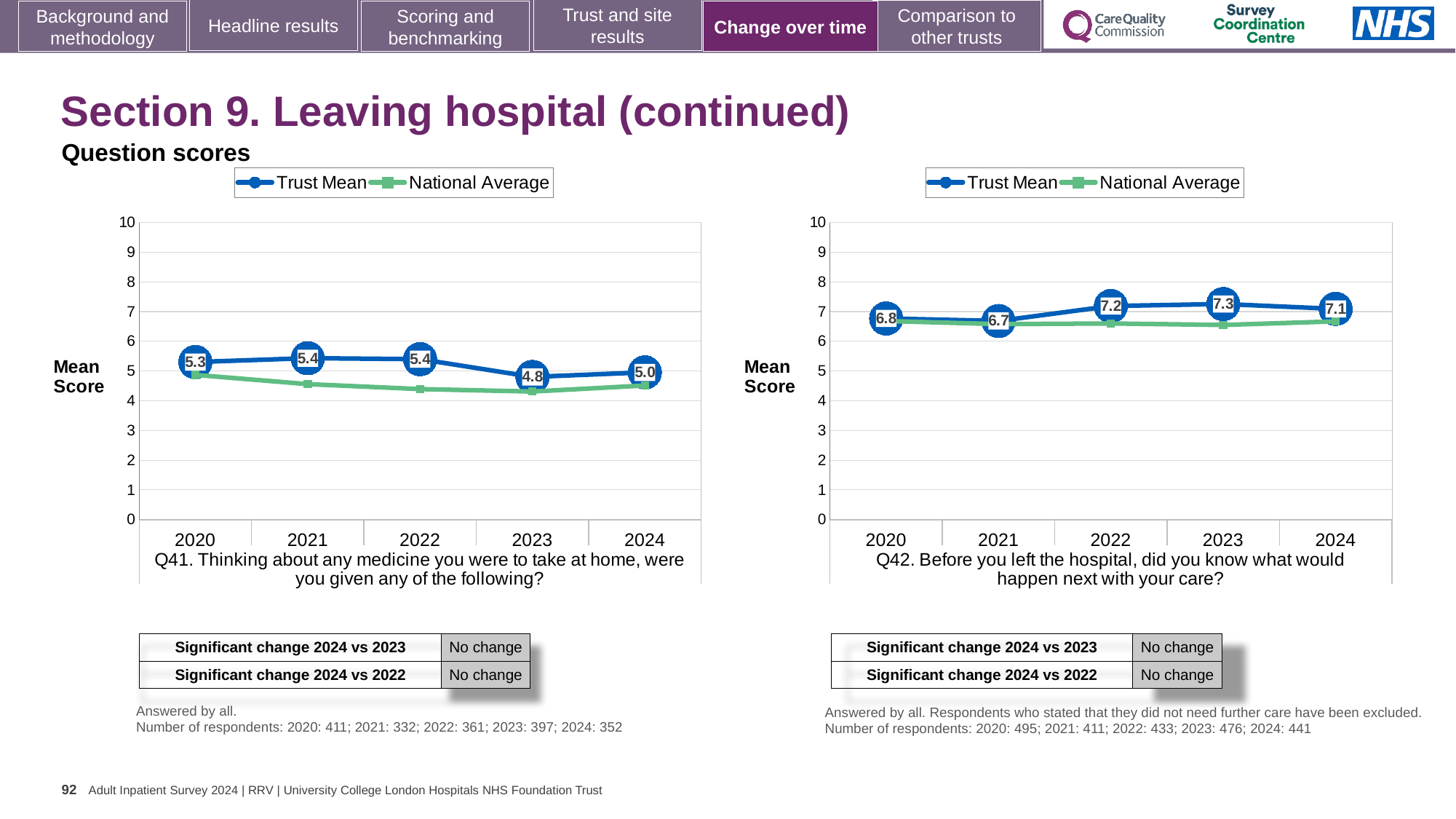
How many years are plotted on the x axis of the Q42 chart (right)? 5 In the Q42 chart (right), which year has the highest Trust Mean score? 2023 In the Q41 chart (left), is the National Average for 2022 greater or less than 5? less In the Q42 chart (right), what is the difference between the Trust Mean scores for 2023 and 2021? 0.6 In the Q42 chart (right), what is the Trust Mean score for 2024? 7.1 In the Q41 chart (left), what is the difference between the Trust Mean scores for 2021 and 2023? 0.6 In the Q41 chart (left), what is the Trust Mean score for 2020? 5.3 In the Q42 chart (right), which is larger, the Trust Mean for 2020 or for 2022? 2022 What type of chart is the Q41 chart (left)? Line chart How many series does the legend of the Q41 chart (left) list? 2 In the Q41 chart (left), what is the Trust Mean score for 2023? 4.8 In the Q41 chart (left), which year has the lowest Trust Mean score? 2023